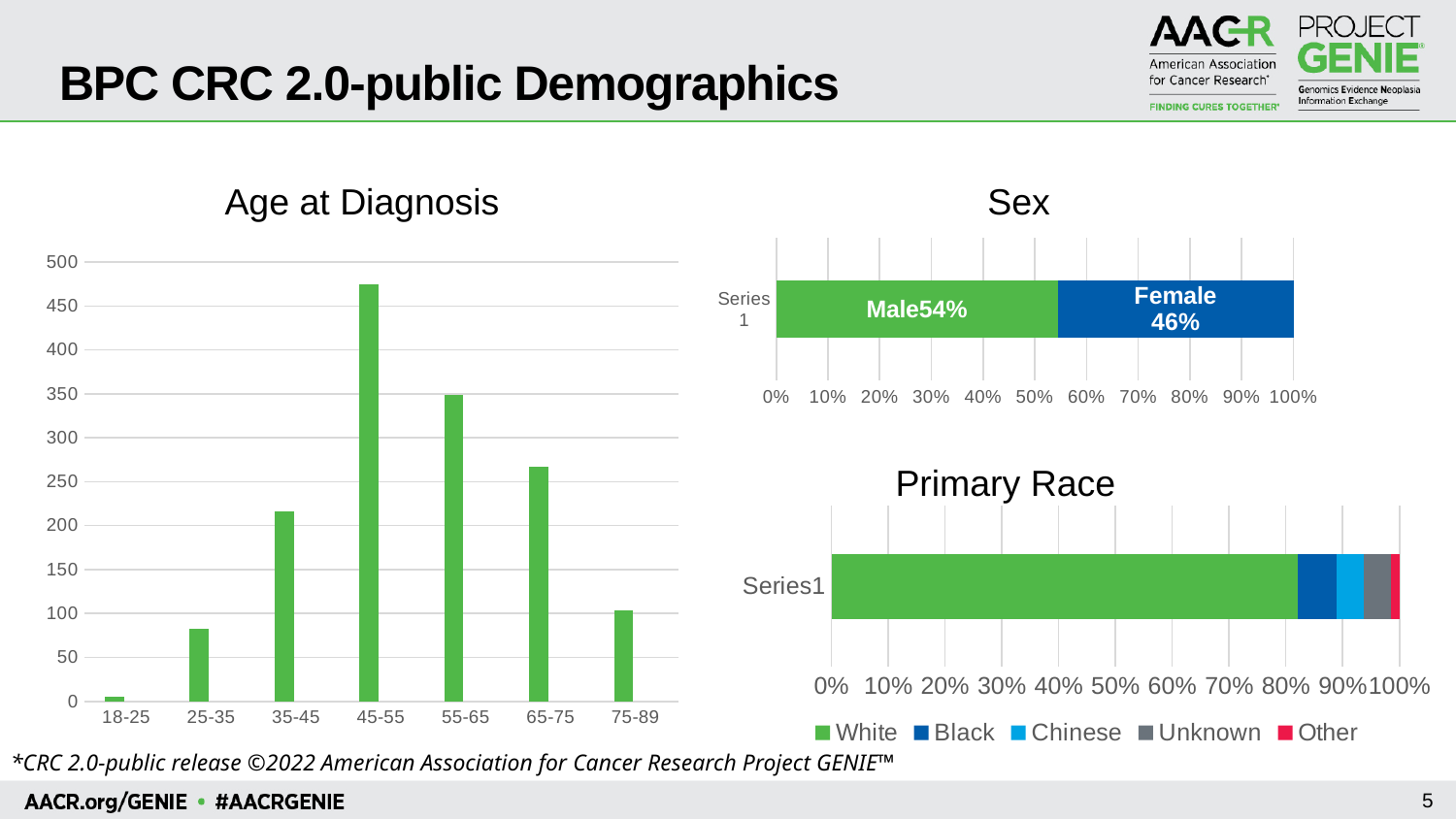
How many age groups are shown in the Age at Diagnosis chart? 7 What kind of chart is the Age at Diagnosis chart? bar chart In the Age at Diagnosis chart, which age group has the lowest value? 18-25 In the Age at Diagnosis chart, is the value for 65-75 greater or less than 250? greater In the Sex chart, what percentage is Male? 54% In the Age at Diagnosis chart, is the value for 25-35 greater or less than 100? less In the Sex chart, what is the difference between the Male and Female percentages? 8% In the Age at Diagnosis chart, which age group has the highest value? 45-55 In the Age at Diagnosis chart, is the value for 45-55 greater or less than 450? greater How many series does the legend of the Primary Race chart list? 5 In the Primary Race chart, which race makes up the largest share of the bar? White In the Age at Diagnosis chart, which is larger, the value for 35-45 or the value for 55-65? 55-65